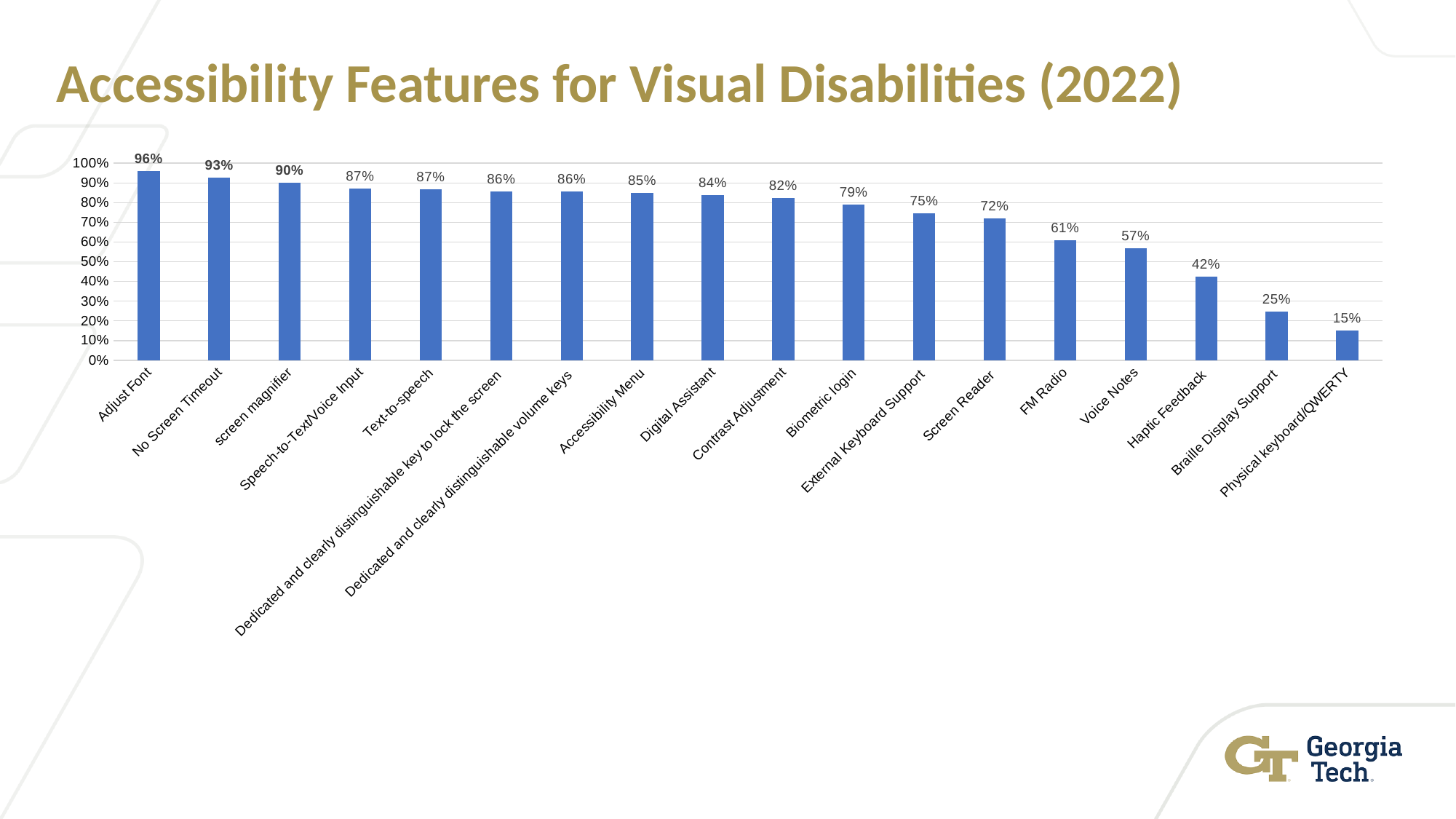
What is the value for Adjust Font? 96% Which is larger, the value for FM Radio or the value for Voice Notes? FM Radio Which category has the lowest value? Physical keyboard/QWERTY What is the value for Screen Reader? 72% Which category has the highest value? Adjust Font What is the title of the chart? Accessibility Features for Visual Disabilities (2022) How many categories are shown on the chart? 18 What is the value for Braille Display Support? 25% Is the value for Biometric login greater or less than 70%? greater Do the values rise or fall from left to right along the x axis? Fall What kind of chart is shown on the slide? Bar chart What is the difference between the values for No Screen Timeout and Haptic Feedback? 51%